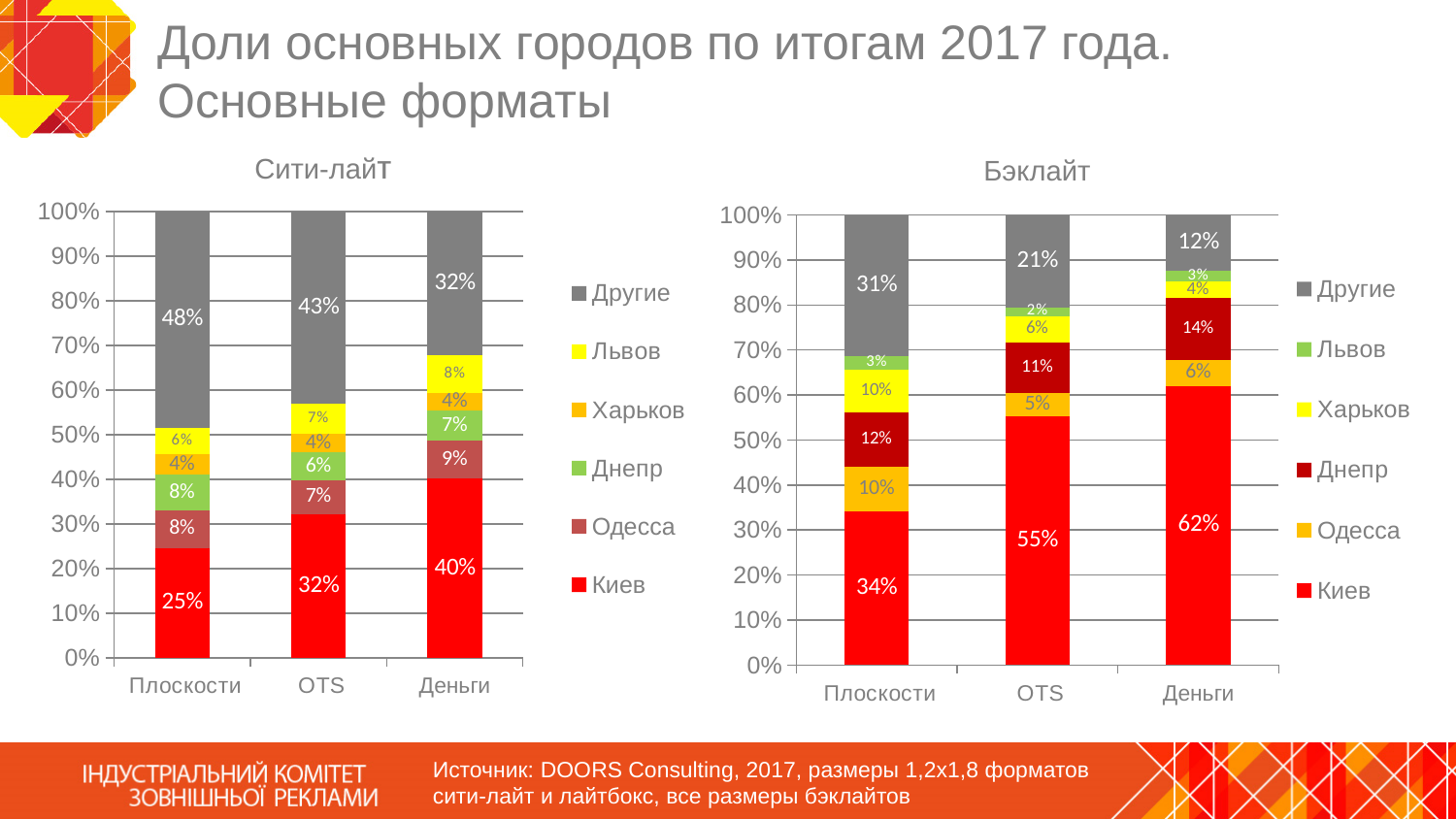
In the Бэклайт chart, what is the value for Днепр in the Плоскости bar? 12% In the Бэклайт chart, which category has the lowest value for Киев? Плоскости In the Сити-лайт chart, what is the value for Киев in the Деньги bar? 40% How many categories are shown on the x axis of the Бэклайт chart? 3 In the Сити-лайт chart, which category has the highest value for Другие? Плоскости In the Бэклайт chart, what is the value for Другие in the OTS bar? 21% In the Сити-лайт chart, is the Другие value for OTS greater or less than 40%? greater In the Бэклайт chart, which is larger: the Киев value for OTS or the Киев value for Деньги? Деньги In the Бэклайт chart, do the Киев values rise or fall from Плоскости to Деньги? Rise In the Сити-лайт chart, what is the difference between the Киев values for Деньги and Плоскости? 15% What kind of chart is the Бэклайт chart? Stacked bar chart How many series does the legend of the Сити-лайт chart list? 6